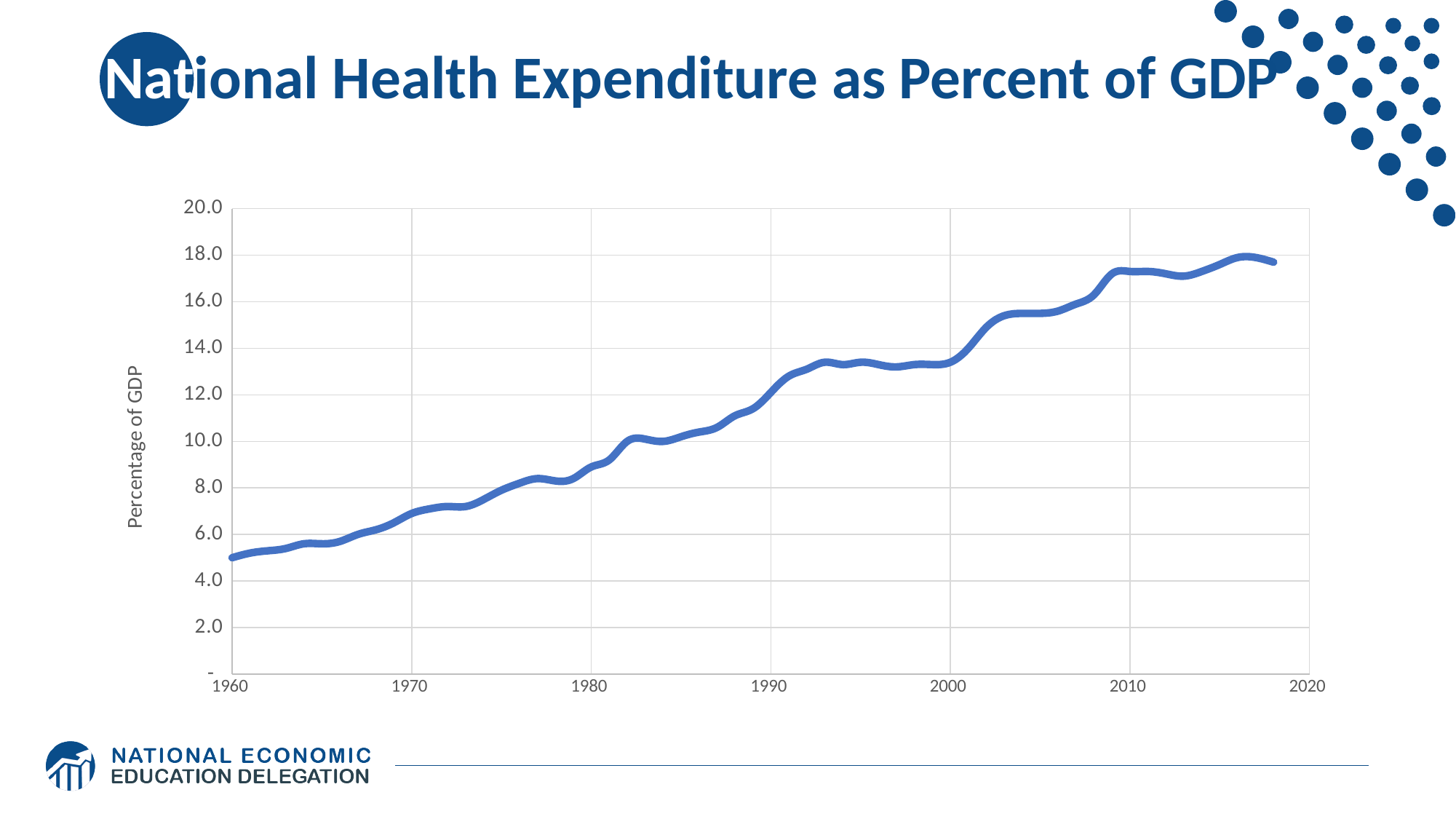
Which year has the larger value, 1980 or 1990? 1990 Overall, does the value rise or fall from 1960 to 2020? rise What is the title of the chart? National Health Expenditure as Percent of GDP Is the value for 1960 greater or less than 6.0? less What kind of chart is shown on the slide? line chart What is the label on the vertical axis? Percentage of GDP Is the value for 1980 greater or less than 8.0? greater Is the value for 2010 greater or less than 16.0? greater Which year has the larger value, 2000 or 2010? 2010